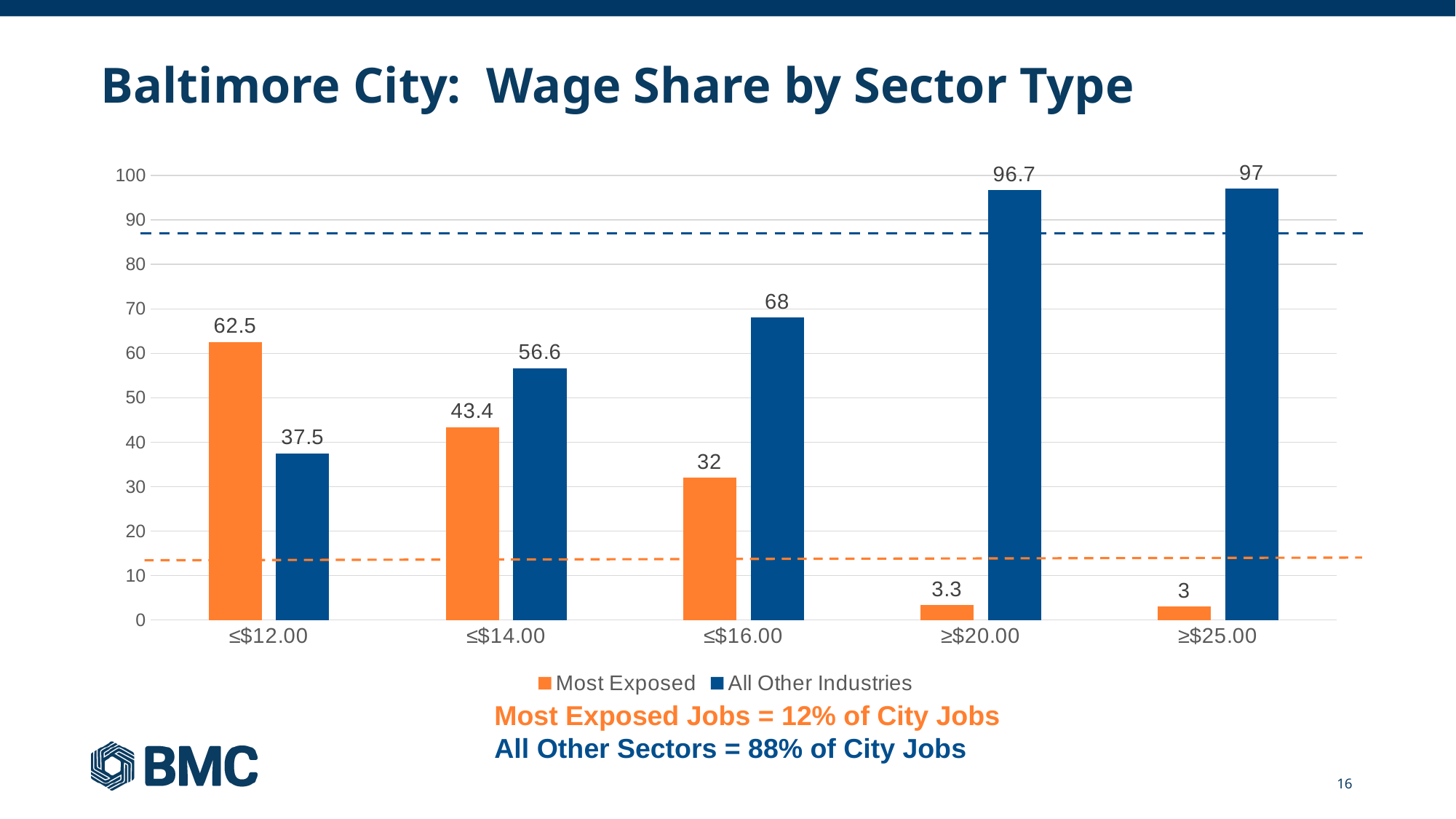
Which category has the highest All Other Industries value? ≥$25.00 What is the difference between the Most Exposed and All Other Industries values for the ≤$14.00 category? 13.2 Which category has the lowest Most Exposed value? ≥$25.00 What is the Most Exposed value for the ≤$12.00 category? 62.5 For the ≤$12.00 category, which series has the larger value, Most Exposed or All Other Industries? Most Exposed What colour are the Most Exposed bars? Orange How many series does the legend list? 2 How many wage categories are shown on the x axis? 5 What is the All Other Industries value for the ≥$20.00 category? 96.7 Do the Most Exposed values rise or fall moving from ≤$12.00 to ≥$25.00 along the x axis? Fall What kind of chart is shown on the slide? Bar chart What is the Most Exposed value for the ≤$16.00 category? 32